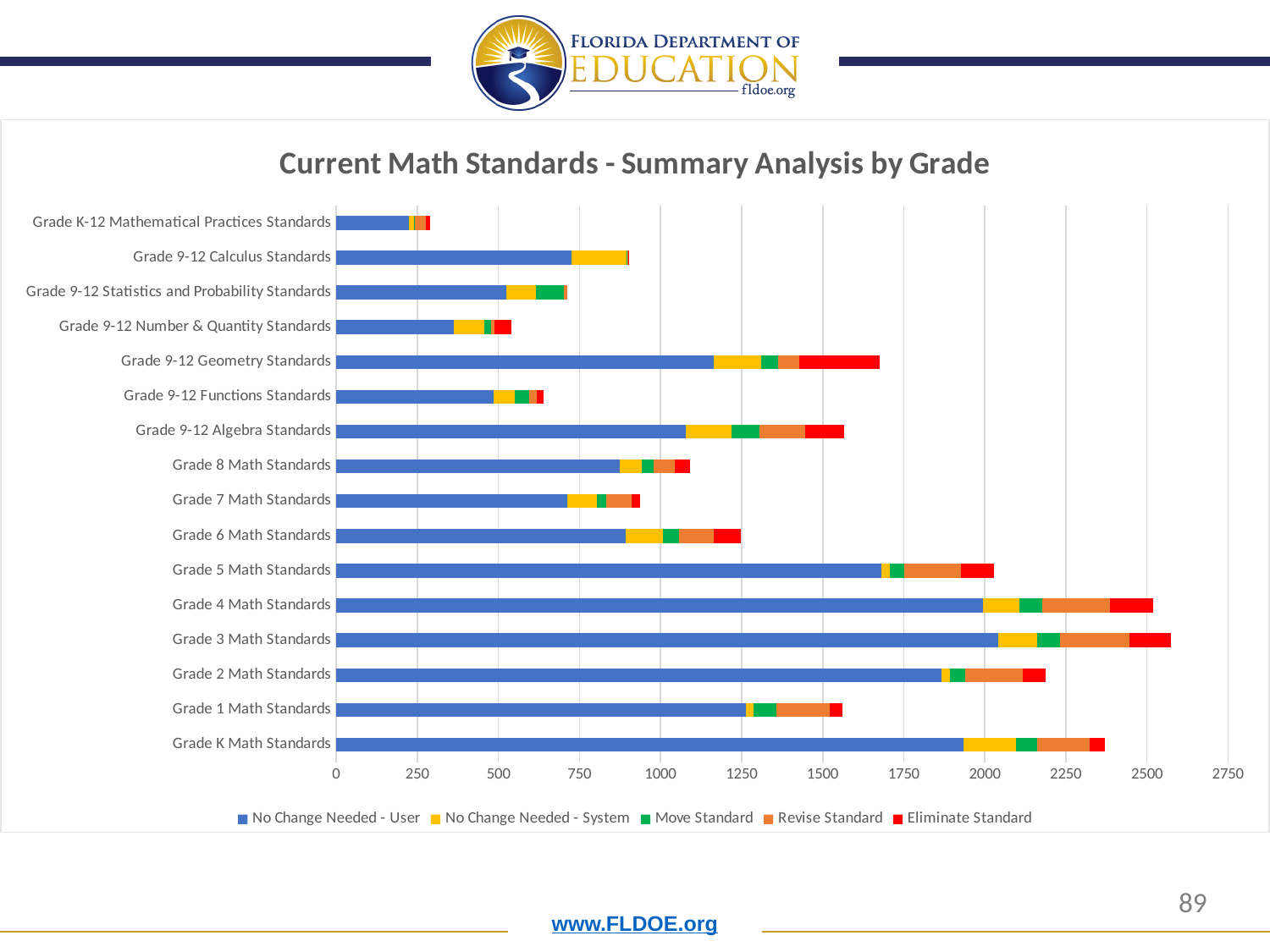
Is the total bar for Grade 9-12 Calculus Standards greater or less than 1000? less How many grade categories are plotted on the chart? 16 What kind of chart is shown on the slide? Stacked bar chart What is the title of the chart? Current Math Standards - Summary Analysis by Grade How many series does the legend list? 5 Is the total bar for Grade K-12 Mathematical Practices Standards greater or less than 500? less Which series is shown in red in the legend? Eliminate Standard Is the total bar for Grade 9-12 Geometry Standards greater or less than 1500? greater Which has the longer total bar, Grade K Math Standards or Grade 1 Math Standards? Grade K Math Standards Which category has the shortest total bar? Grade K-12 Mathematical Practices Standards Which has the longer total bar, Grade 9-12 Algebra Standards or Grade 9-12 Functions Standards? Grade 9-12 Algebra Standards